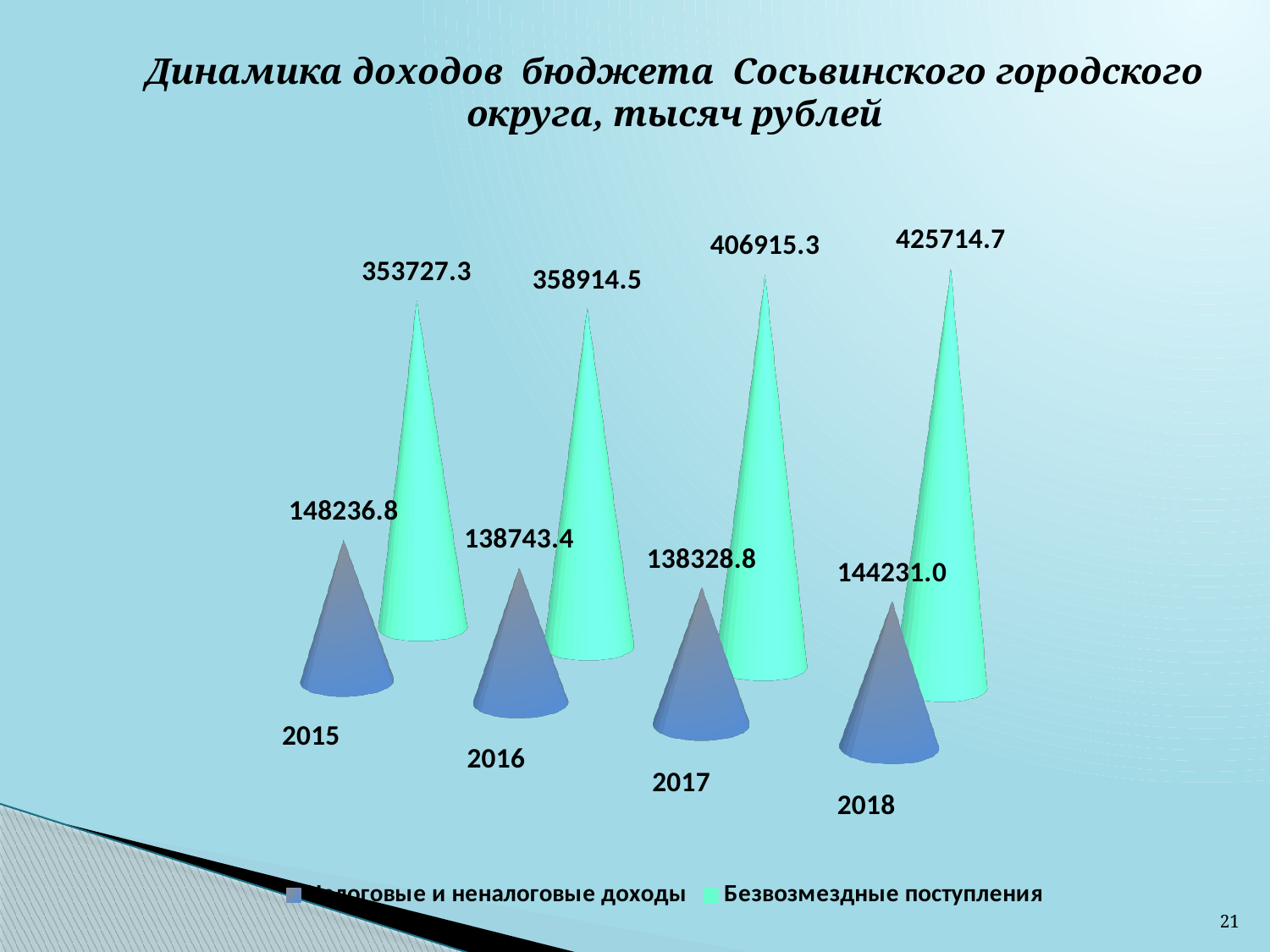
What is the value of Безвозмездные поступления for 2018? 425714.7 What is the value of Налоговые и неналоговые доходы for 2015? 148236.8 What is the total of Налоговые и неналоговые доходы and Безвозмездные поступления for 2016? 497657.9 Does Безвозмездные поступления rise or fall from 2015 to 2018? rise How many series does the legend list? 2 Which is larger: Налоговые и неналоговые доходы in 2015 or in 2018? 2015 How many years are shown on the chart? 4 What is the value of Безвозмездные поступления for 2016? 358914.5 What is the difference between Безвозмездные поступления in 2018 and in 2017? 18799.4 What is the value of Налоговые и неналоговые доходы for 2017? 138328.8 In which year is Налоговые и неналоговые доходы lowest? 2017 In which year is Безвозмездные поступления highest? 2018